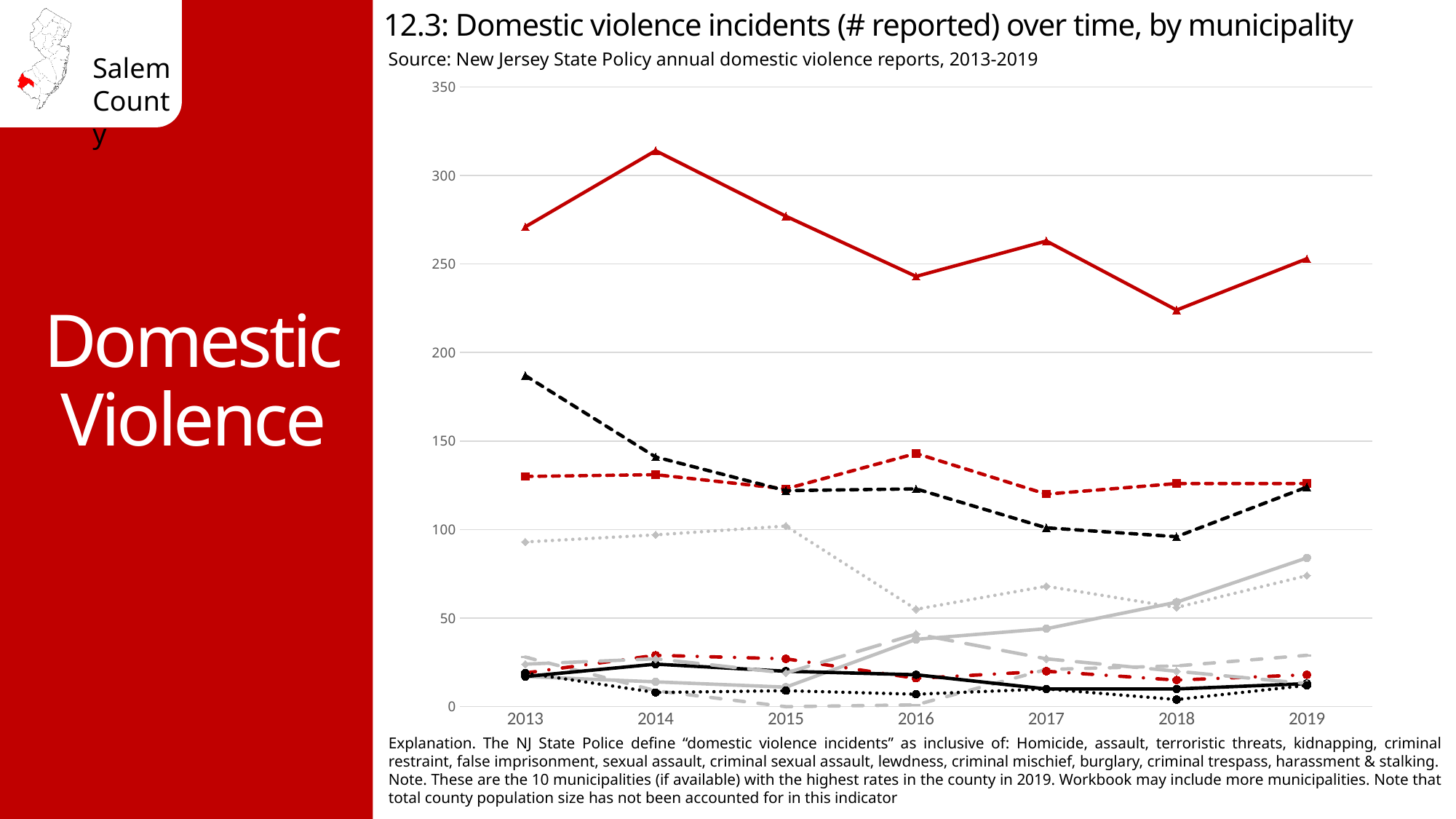
What kind of chart is shown on the slide? line chart What is the title of the chart? 12.3: Domestic violence incidents (# reported) over time, by municipality In which year does the solid red line reach its highest value? 2014 In which year does the solid red line reach its lowest value? 2018 Does the solid light grey line rise or fall from 2016 to 2019? rise Does the black dashed line with triangle markers rise or fall from 2013 to 2018? fall How many years are shown along the x axis of the chart? 7 What is the first year shown on the x axis? 2013 Is the value of the solid red line in 2018 greater or less than 250? less In 2013, which is higher: the solid red line or the black dashed line with triangle markers? the solid red line Is the value of the black dashed line with triangle markers in 2013 greater or less than 150? greater Is the value of the solid red line in 2014 greater or less than 300? greater